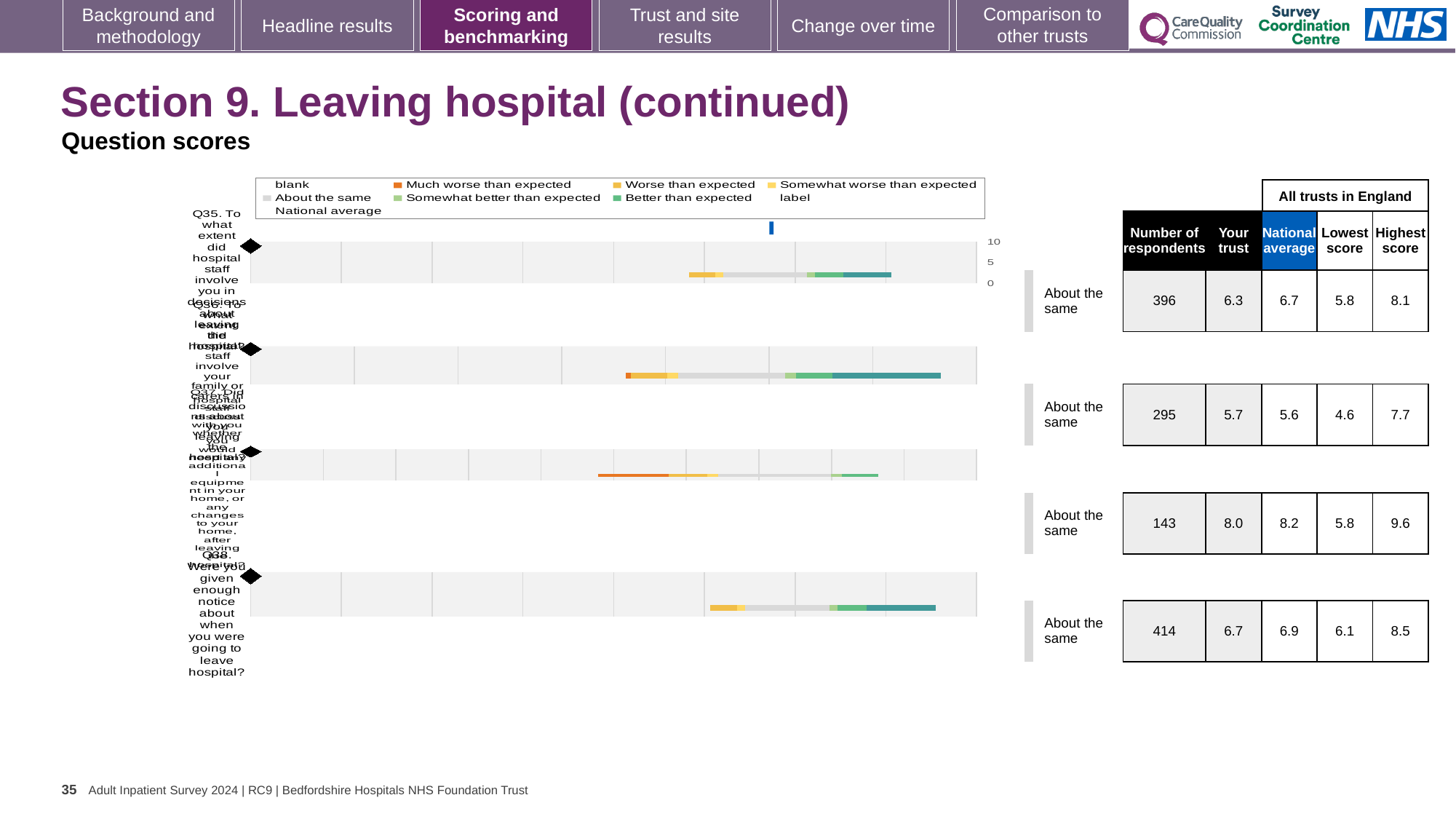
What benchmark category is shown for Q38 (the last row)? About the same What is the lowest score across all trusts in England for the second row (Q36)? 4.6 What kind of chart is used to show the question scores on this slide? bar chart What is the highest score across all trusts in England for the third row (Q37)? 9.6 How many question rows are plotted in the chart? 4 For Q35 (the first row), what is the difference between the national average and the 'Your trust' score? 0.4 For Q38 (the last row), what is the difference between the highest score and the lowest score across all trusts in England? 2.4 Which question row has the lowest number of respondents? Q37 (third row), 143 What is the number of respondents for Q35 (the first row)? 396 Which question row has the highest 'Your trust' score? Q37 (third row), 8.0 What is the 'Your trust' score for Q38 (the last row)? 6.7 For the second row (Q36), which is larger: the 'Your trust' score or the national average? Your trust (5.7)